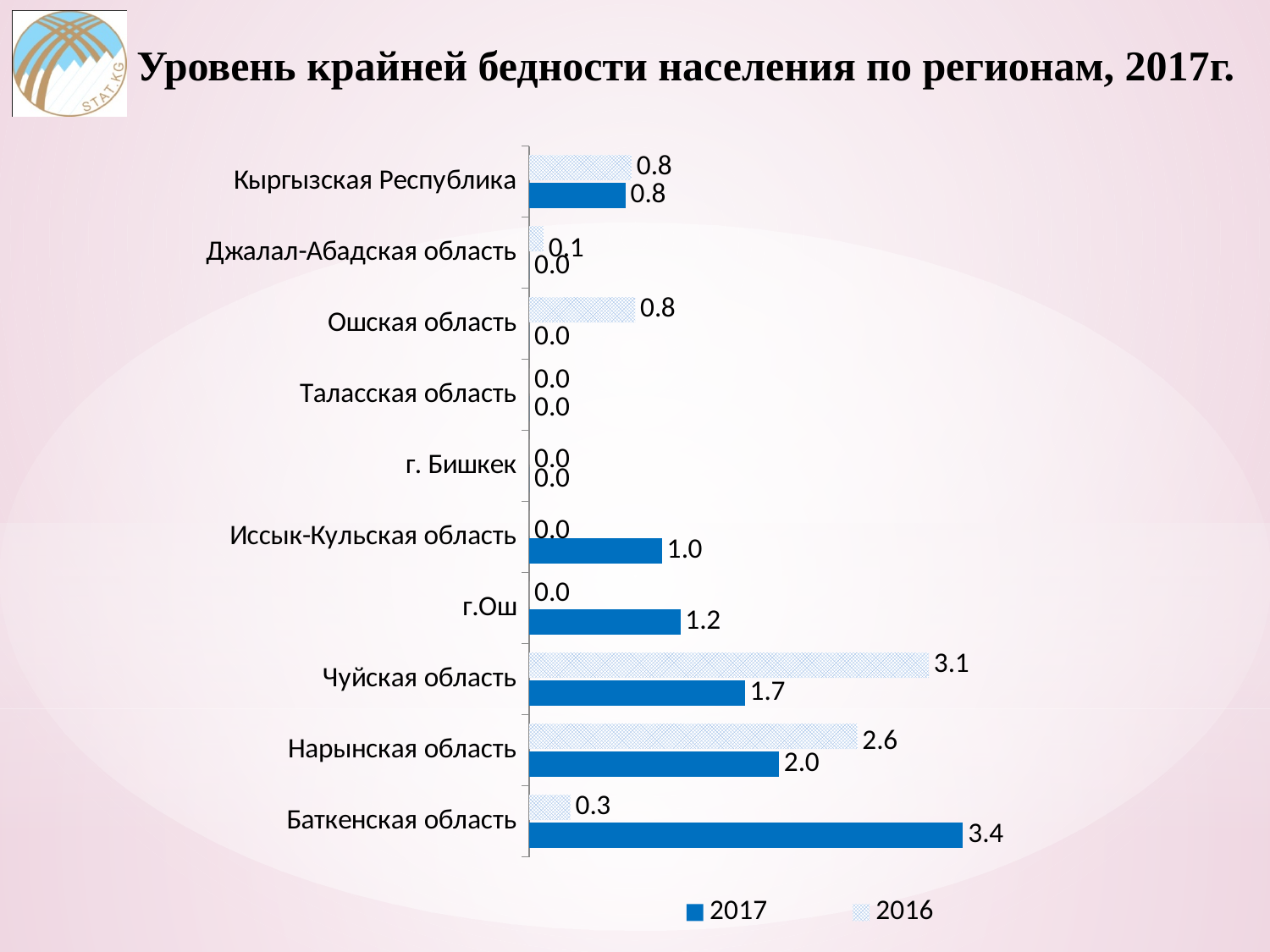
What is the 2016 value for Джалал-Абадская область? 0.1 What is the difference between the 2016 and 2017 values for Чуйская область? 1.4 Which region has the highest 2016 value? Чуйская область What is the 2017 value for Баткенская область? 3.4 How many series does the legend list? 2 What is the 2017 value for Нарынская область? 2.0 What kind of chart is shown on the slide? Bar chart What is the 2016 value for Чуйская область? 3.1 Which region has the highest 2017 value? Баткенская область What is the difference between the 2017 and 2016 values for Баткенская область? 3.1 Which is larger for Нарынская область, the 2016 value or the 2017 value? 2016 How many regions (categories) are shown on the chart? 10